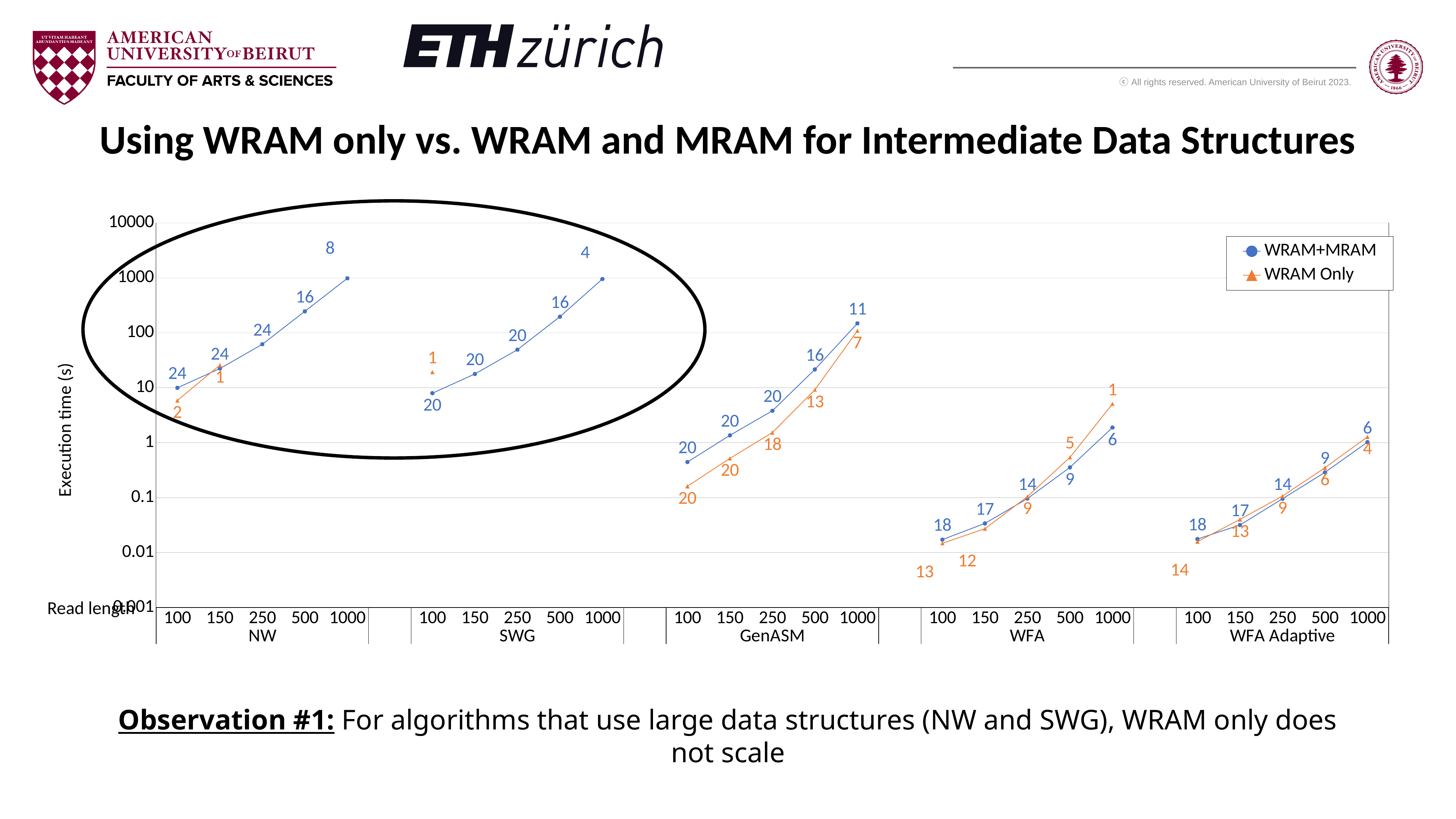
How many read lengths are plotted for each algorithm group? 5 For the NW group, does the WRAM+MRAM execution time rise or fall as read length increases? rise How many algorithm groups are shown along the x axis? 5 What kind of chart is shown on the slide? line chart How many series does the legend list? 2 Is the WRAM+MRAM execution time for NW at read length 1000 greater or less than 100? greater For GenASM at read length 100, which series has the higher execution time, WRAM+MRAM or WRAM Only? WRAM+MRAM How many WRAM Only points are plotted for the SWG group? 1 For WFA at read length 1000, which series has the higher execution time, WRAM+MRAM or WRAM Only? WRAM Only Is the WRAM+MRAM execution time for WFA Adaptive at read length 100 greater or less than 0.1? less Is the WRAM+MRAM execution time for SWG at read length 100 greater or less than 1? greater What are the two series named in the legend? WRAM+MRAM and WRAM Only